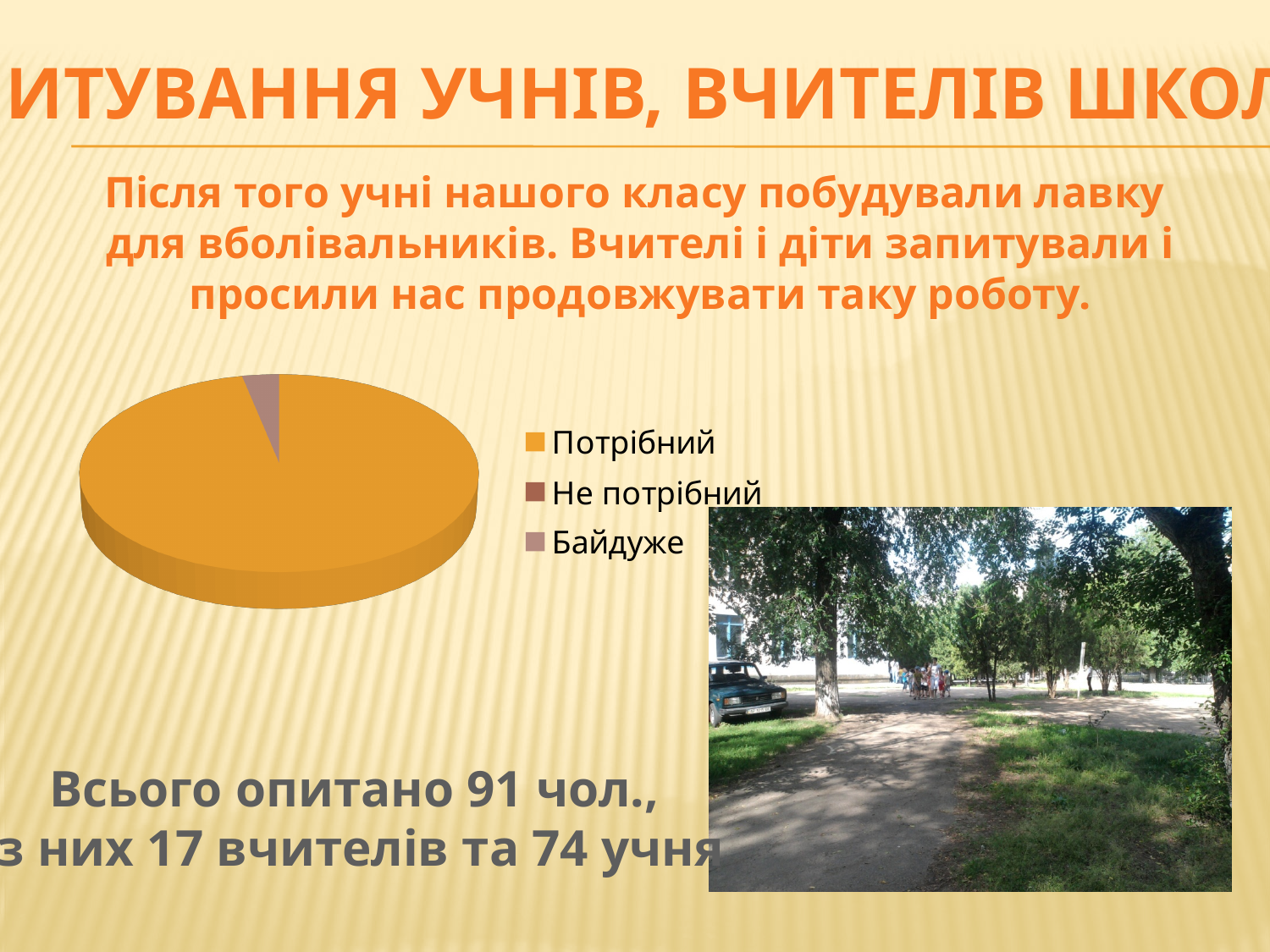
Which legend entry is listed second in the pie chart's legend? Не потрібний What colour is the Потрібний slice in the pie chart? orange Which category has the largest slice of the pie chart? Потрібний How many entries does the legend of the pie chart list? 3 Which slice is larger in the pie chart, Потрібний or Байдуже? Потрібний Does the Потрібний slice take up more or less than half of the pie chart? more What kind of chart is shown on the slide? pie chart